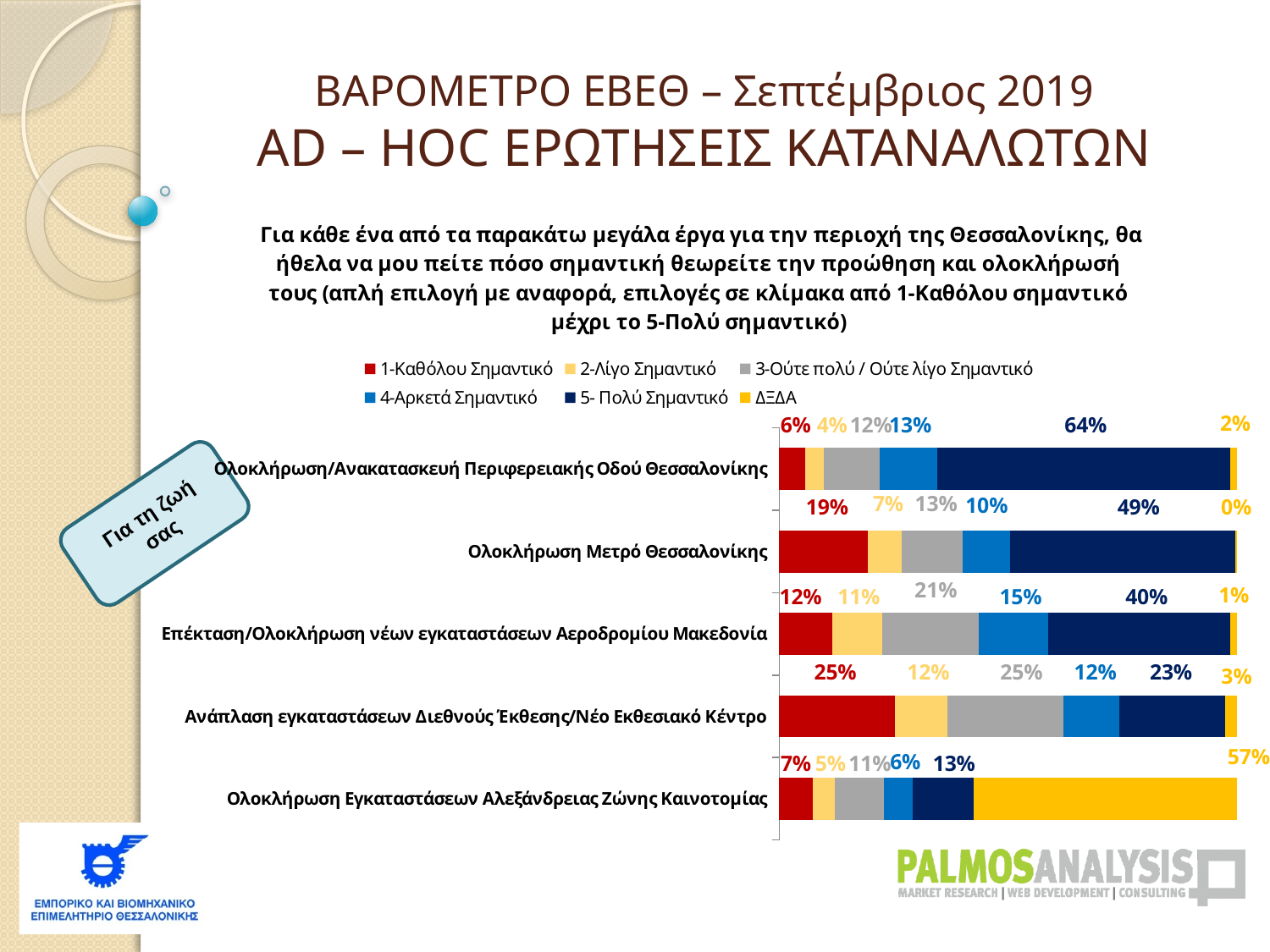
What is the value of '3-Ούτε πολύ / Ούτε λίγο Σημαντικό' for 'Επέκταση/Ολοκλήρωση νέων εγκαταστάσεων Αεροδρομίου Μακεδονία'? 21% How many projects (categories) are shown in the chart? 5 How many series does the legend list? 6 Which project has the highest '5- Πολύ Σημαντικό' value? Ολοκλήρωση/Ανακατασκευή Περιφερειακής Οδού Θεσσαλονίκης What is the value of '5- Πολύ Σημαντικό' for 'Ολοκλήρωση/Ανακατασκευή Περιφερειακής Οδού Θεσσαλονίκης'? 64% What is the difference between the '5- Πολύ Σημαντικό' values for 'Ολοκλήρωση/Ανακατασκευή Περιφερειακής Οδού Θεσσαλονίκης' and 'Ολοκλήρωση Μετρό Θεσσαλονίκης'? 15% Which is larger: the '1-Καθόλου Σημαντικό' value for 'Ανάπλαση εγκαταστάσεων Διεθνούς Έκθεσης/Νέο Εκθεσιακό Κέντρο' or for 'Ολοκλήρωση Μετρό Θεσσαλονίκης'? Ανάπλαση εγκαταστάσεων Διεθνούς Έκθεσης/Νέο Εκθεσιακό Κέντρο What is the value of 'ΔΞΔΑ' for 'Ολοκλήρωση Εγκαταστάσεων Αλεξάνδρειας Ζώνης Καινοτομίας'? 57% What is the value of '1-Καθόλου Σημαντικό' for 'Ολοκλήρωση Μετρό Θεσσαλονίκης'? 19% What kind of chart is shown on the slide? Stacked bar chart Which project has the lowest '5- Πολύ Σημαντικό' value? Ολοκλήρωση Εγκαταστάσεων Αλεξάνδρειας Ζώνης Καινοτομίας What is the combined value of '4-Αρκετά Σημαντικό' and '5- Πολύ Σημαντικό' for 'Επέκταση/Ολοκλήρωση νέων εγκαταστάσεων Αεροδρομίου Μακεδονία'? 55%